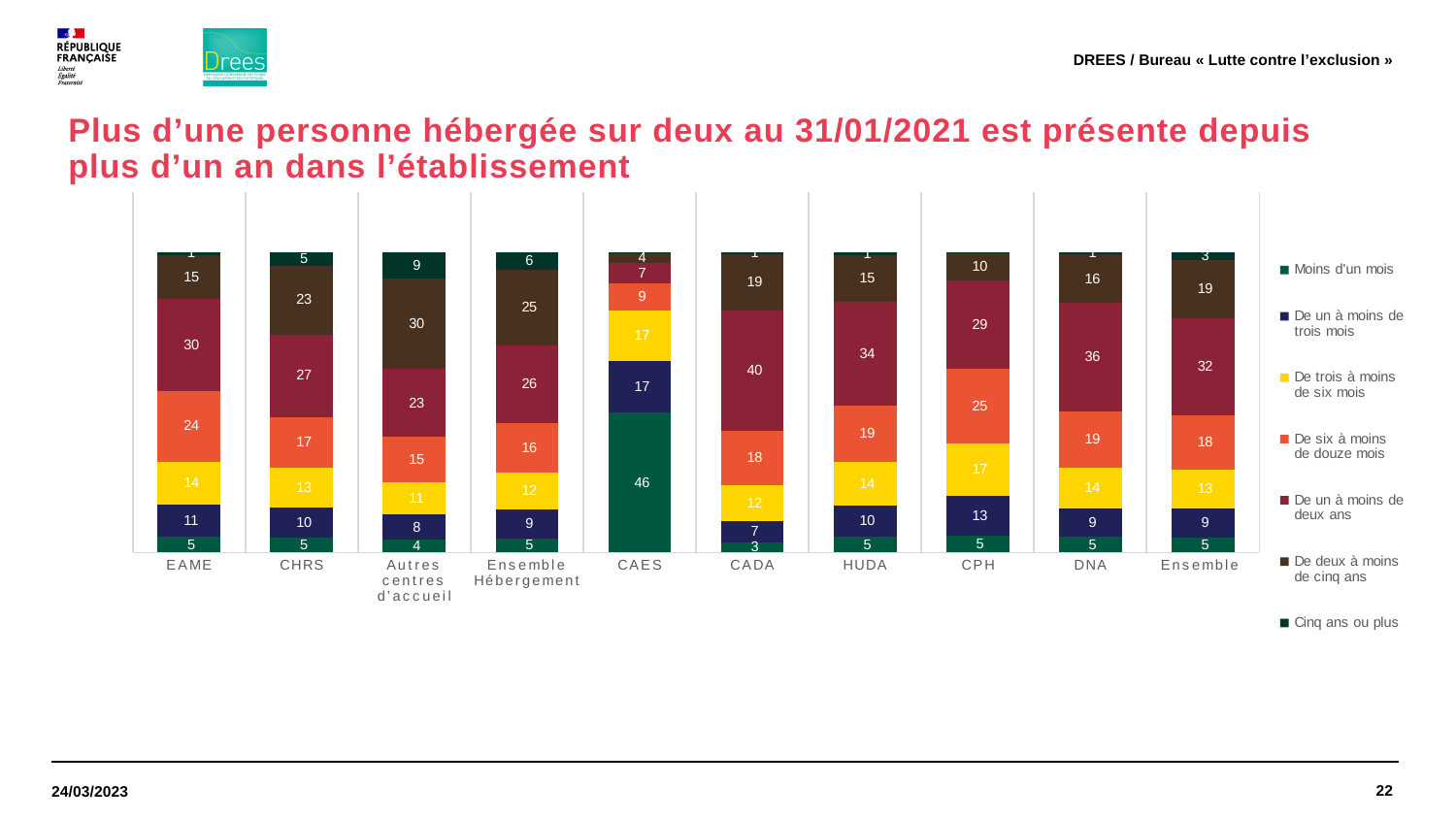
What is the value of 'Moins d'un mois' for CAES? 46 What is the value of 'De un à moins de deux ans' for CADA? 40 How many categories are shown on the x axis? 10 What is the difference between the 'De un à moins de deux ans' values for CADA and EAME? 10 How many series does the legend list? 7 What is the value of 'De six à moins de douze mois' for CPH? 25 What is the value of 'De deux à moins de cinq ans' for Autres centres d'accueil? 30 Which legend entry is shown in yellow? De trois à moins de six mois What kind of chart is shown on the slide? Stacked bar chart Which is larger: the 'De deux à moins de cinq ans' value for CHRS or for HUDA? CHRS Which category has the highest value for 'Moins d'un mois'? CAES Which category has the lowest value for 'De un à moins de deux ans'? CAES